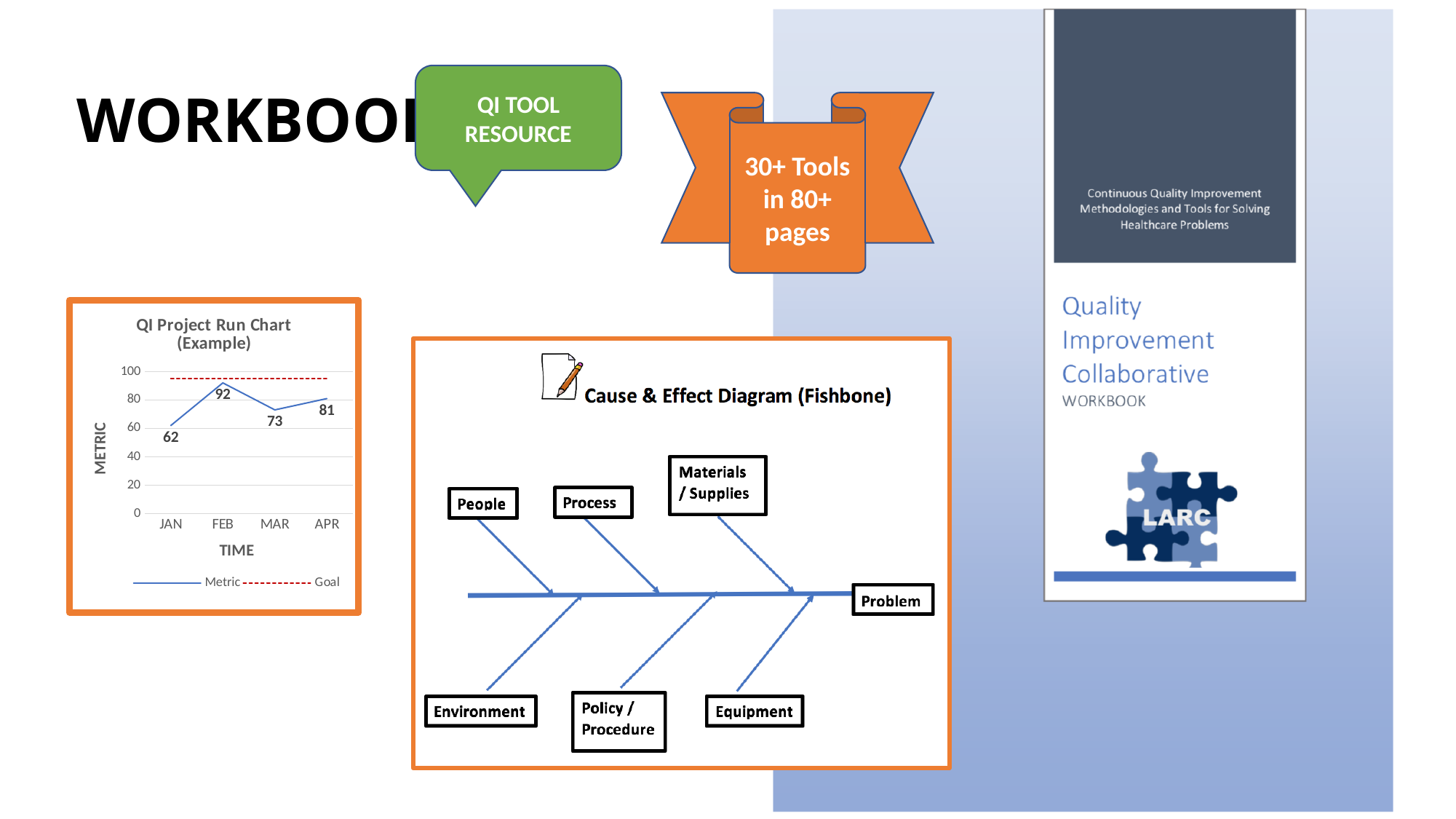
In the QI Project Run Chart (Example), which month has the lowest Metric value? JAN How many series does the legend of the QI Project Run Chart (Example) list? 2 How many months are shown on the x axis of the QI Project Run Chart (Example)? 4 In the QI Project Run Chart (Example), what is the Metric value for JAN? 62 In the QI Project Run Chart (Example), what is the Metric value for FEB? 92 In the QI Project Run Chart (Example), what is the Metric value for MAR? 73 In the QI Project Run Chart (Example), which month has the larger Metric value, MAR or APR? APR What kind of chart is the QI Project Run Chart (Example)? line chart In the QI Project Run Chart (Example), which month has the highest Metric value? FEB In the QI Project Run Chart (Example), is the Goal line greater or less than 80? greater In the QI Project Run Chart (Example), does the Metric rise or fall from FEB to MAR? fall In the QI Project Run Chart (Example), what is the difference between the Metric values for FEB and MAR? 19